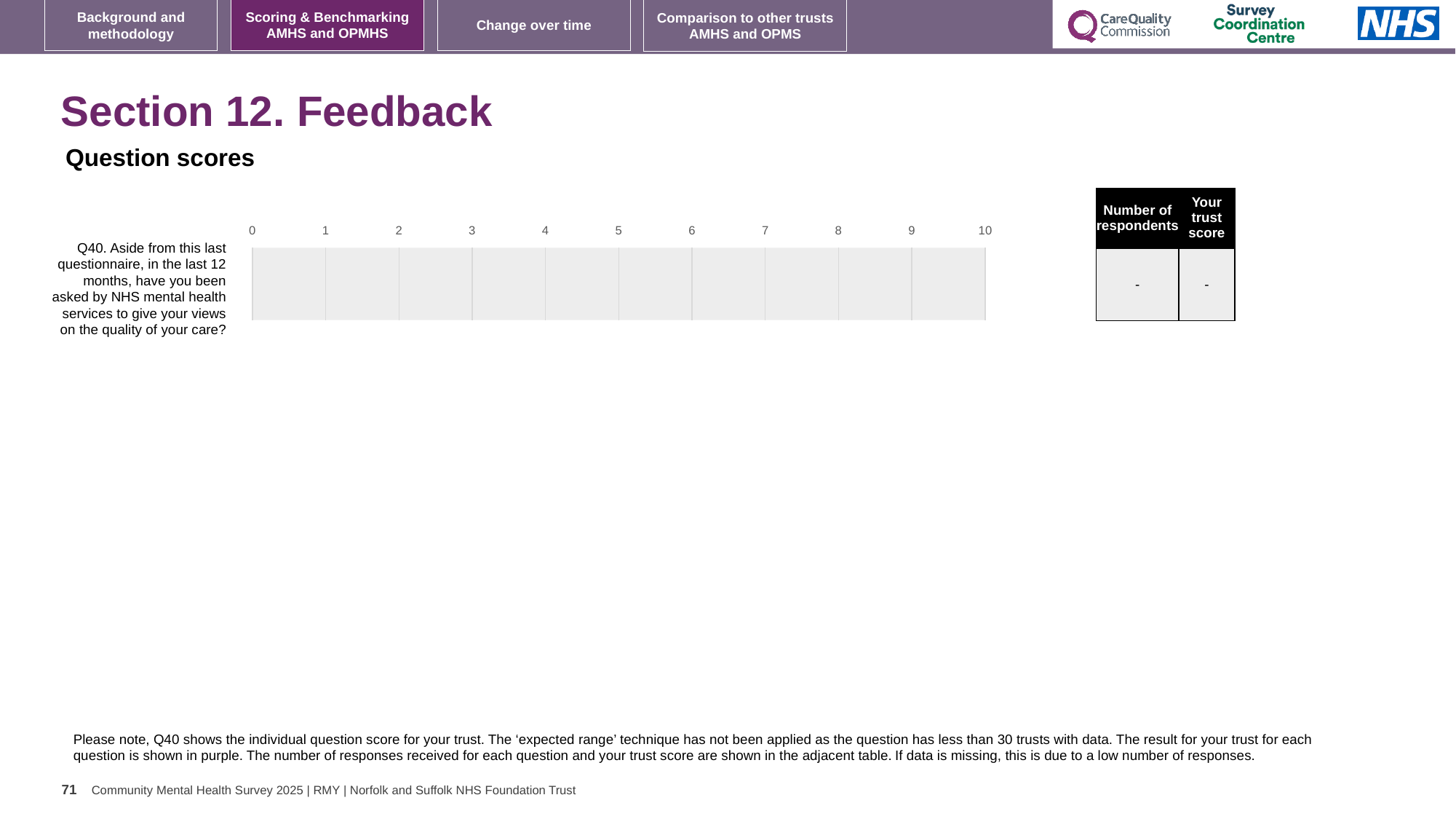
How many tick labels are shown along the chart's x axis? 11 What is the 'Your trust score' value shown in the table for Q40? - How many questions (categories) are plotted on the chart? 1 What is the lowest value shown on the chart's x axis? 0 What is the highest value shown on the chart's x axis? 10 What kind of chart is shown on the slide? Bar chart What is the 'Number of respondents' value shown in the table for Q40? -